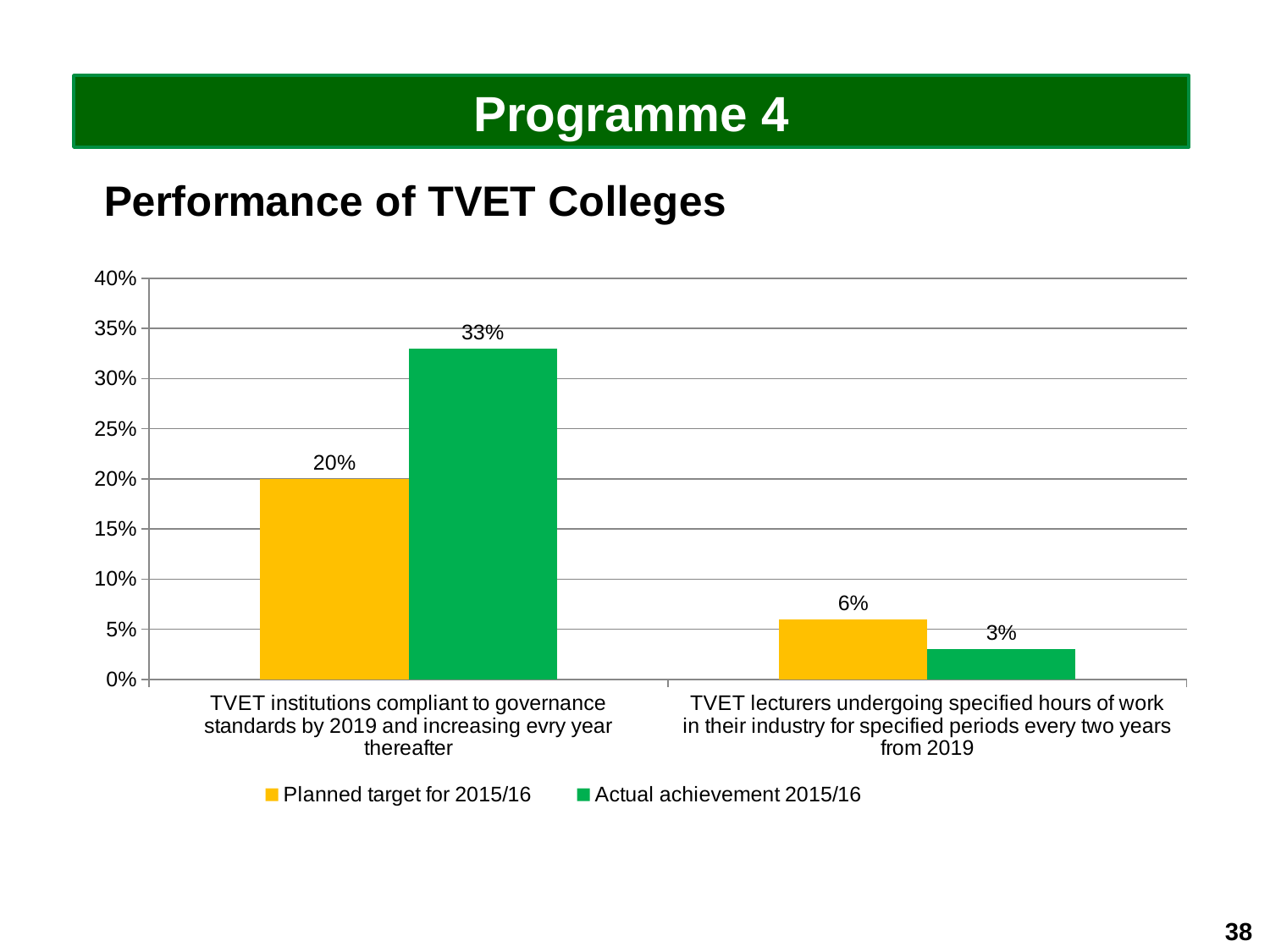
What kind of chart is shown on the slide? Bar chart What is the planned target for 2015/16 for TVET lecturers undergoing specified hours of work in their industry? 6% What is the difference between the planned target and the actual achievement for TVET lecturers undergoing specified hours of work in their industry? 3% For TVET lecturers undergoing specified hours of work in their industry, which is larger: the planned target or the actual achievement? Planned target for 2015/16 What is the planned target for 2015/16 for TVET institutions compliant to governance standards? 20% How many categories are shown on the x axis? 2 What is the difference between the actual achievement and the planned target for TVET institutions compliant to governance standards? 13% Which bar has the lowest value on the chart? Actual achievement 2015/16 for TVET lecturers undergoing specified hours of work in their industry Which bar has the highest value on the chart? Actual achievement 2015/16 for TVET institutions compliant to governance standards What is the actual achievement 2015/16 for TVET institutions compliant to governance standards? 33% What is the actual achievement 2015/16 for TVET lecturers undergoing specified hours of work in their industry? 3% How many series does the legend list? 2